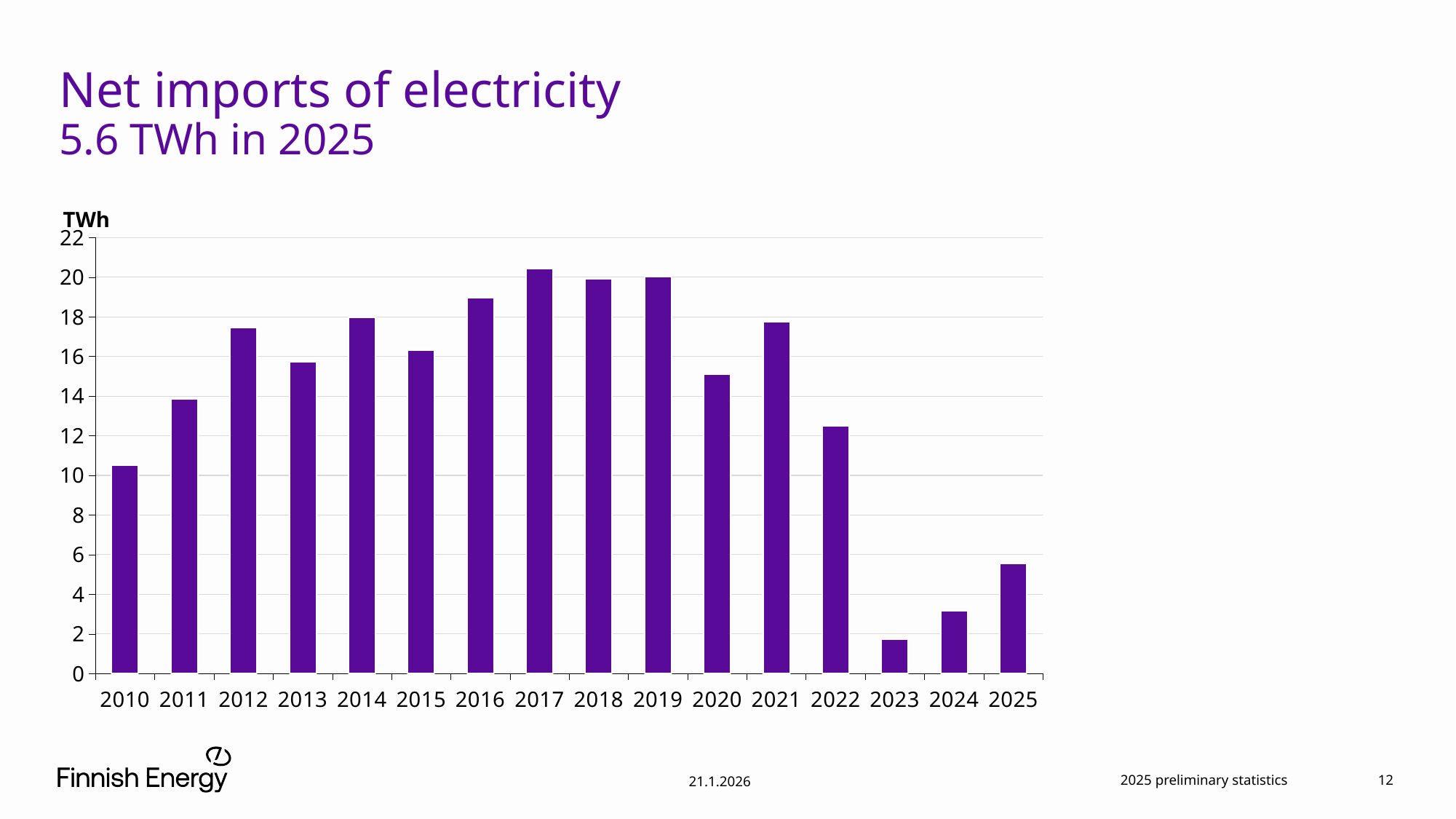
Which year has the highest net imports of electricity? 2017 How many years are shown on the x axis of the chart? 16 Is the value for 2010 greater or less than 10? greater What is the net import of electricity in 2025 according to the slide? 5.6 TWh Do the values rise or fall from 2019 to 2023? fall Which year has the larger value, 2012 or 2013? 2012 What kind of chart is shown on the slide? bar chart Is the value for 2020 greater or less than 16? less Is the value for 2023 greater or less than 2? less Which year has the lowest net imports of electricity? 2023 What unit is shown on the y axis of the chart? TWh